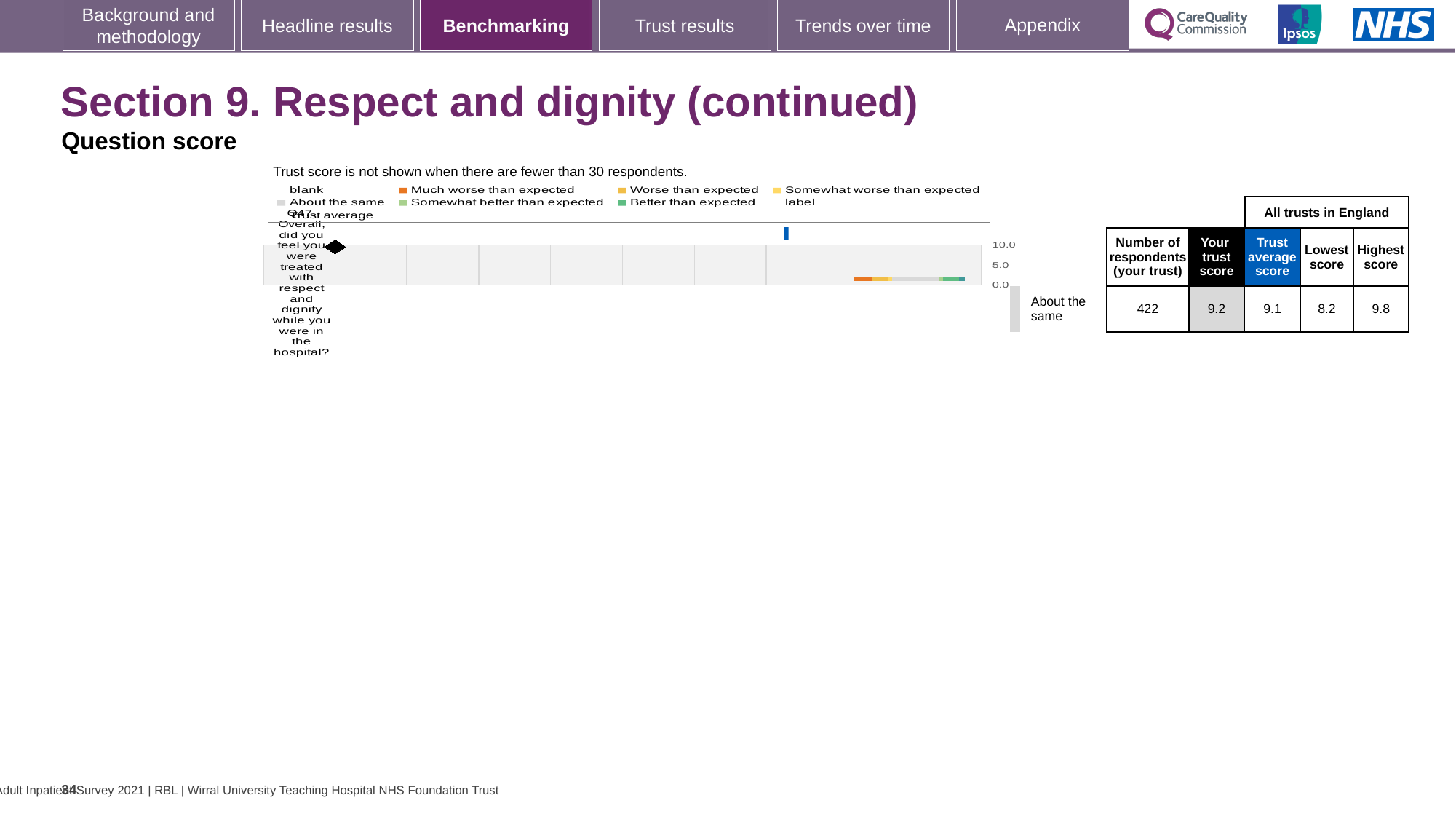
According to the table beside the chart, how many respondents did the trust have for Q47? 422 Which is larger for Q47: your trust score or the trust average score? your trust score What benchmark category is the trust's Q47 score labelled as on the chart? About the same What kind of chart is shown on the slide? bar chart According to the table beside the chart, what is the trust's score for Q47? 9.2 What is the difference between the highest score and the lowest score for Q47 shown in the table beside the chart? 1.6 In the chart legend, what colour represents 'Much worse than expected'? orange How many questions are plotted on the chart? 1 What is the highest value shown on the chart's score axis? 10.0 According to the table beside the chart, what is the trust average score for Q47? 9.1 According to the table beside the chart, what is the highest score among all trusts in England for Q47? 9.8 According to the table beside the chart, what is the lowest score among all trusts in England for Q47? 8.2